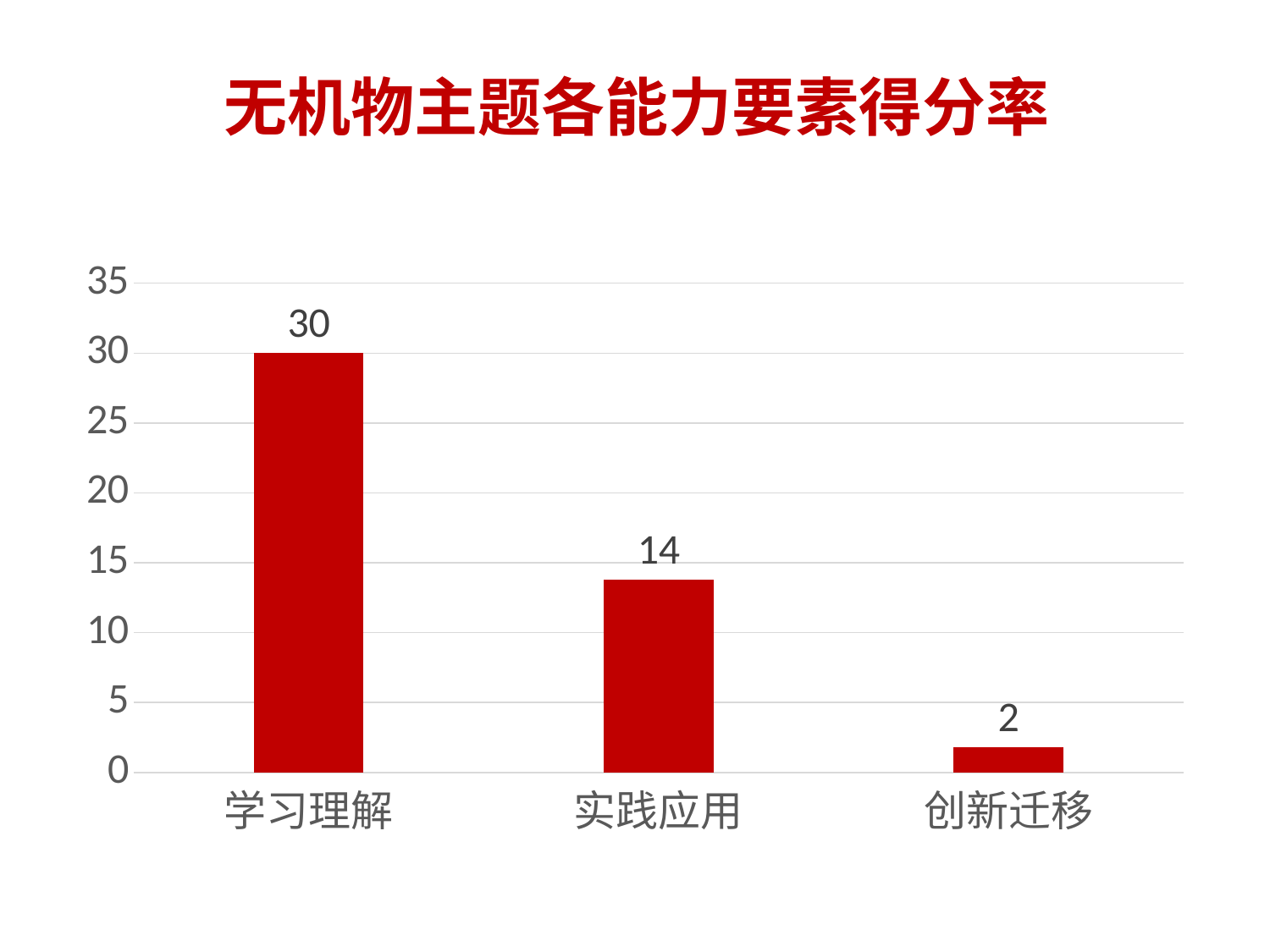
What is the value for 实践应用? 14 How many categories are shown on the x axis? 3 What is the difference between the values for 学习理解 and 实践应用? 16 What is the value for 创新迁移? 2 Is the value for 实践应用 greater or less than 15? less What is the difference between the values for 实践应用 and 创新迁移? 12 Which is larger, the value for 实践应用 or the value for 创新迁移? 实践应用 Do the values rise or fall from left to right along the x axis? fall Which category has the highest value? 学习理解 What is the value for 学习理解? 30 What kind of chart is shown on the slide? bar chart Which category has the lowest value? 创新迁移